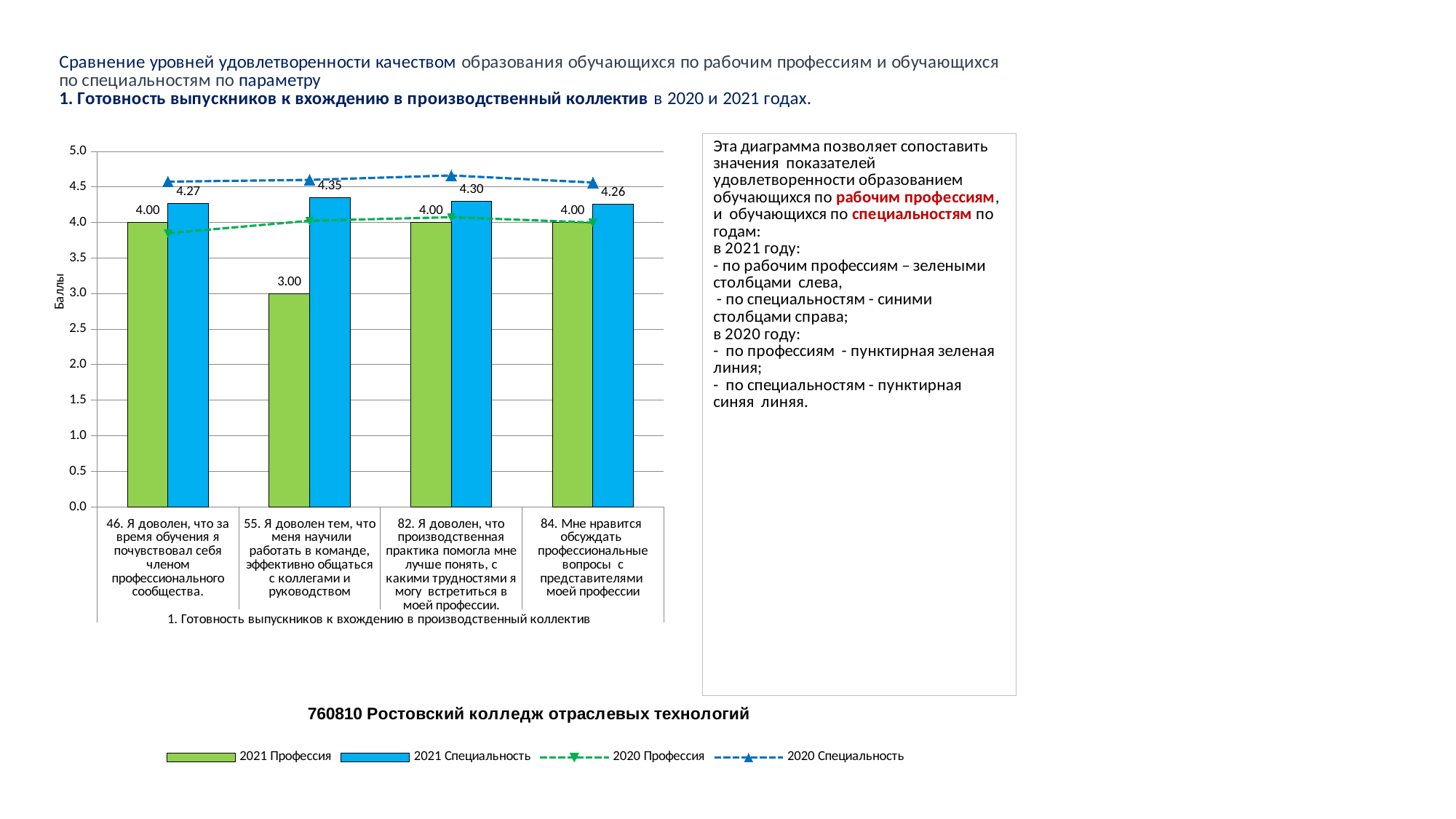
What is the value of the 2021 Профессия bar for category 55 (Я доволен тем, что меня научили работать в команде...)? 3.00 Which category has the lowest 2021 Профессия bar? 55. Я доволен тем, что меня научили работать в команде, эффективно общаться с коллегами и руководством What is the label of the vertical axis of the chart? Баллы Is the 2020 Специальность line value for category 82 greater or less than 4.5? greater Is the 2020 Профессия line value for category 46 greater or less than 4.0? less How many series does the chart legend list? 4 For category 46, which is larger: the 2021 Профессия bar or the 2021 Специальность bar? 2021 Специальность What is the difference between the 2021 Специальность and 2021 Профессия bars for category 55? 1.35 Which category has the highest 2021 Специальность bar? 55. Я доволен тем, что меня научили работать в команде, эффективно общаться с коллегами и руководством What is the value of the 2021 Специальность bar for category 55 (Я доволен тем, что меня научили работать в команде...)? 4.35 How many categories are shown on the x axis of the chart? 4 What is the value of the 2021 Специальность bar for category 84 (Мне нравится обсуждать профессиональные вопросы...)? 4.26